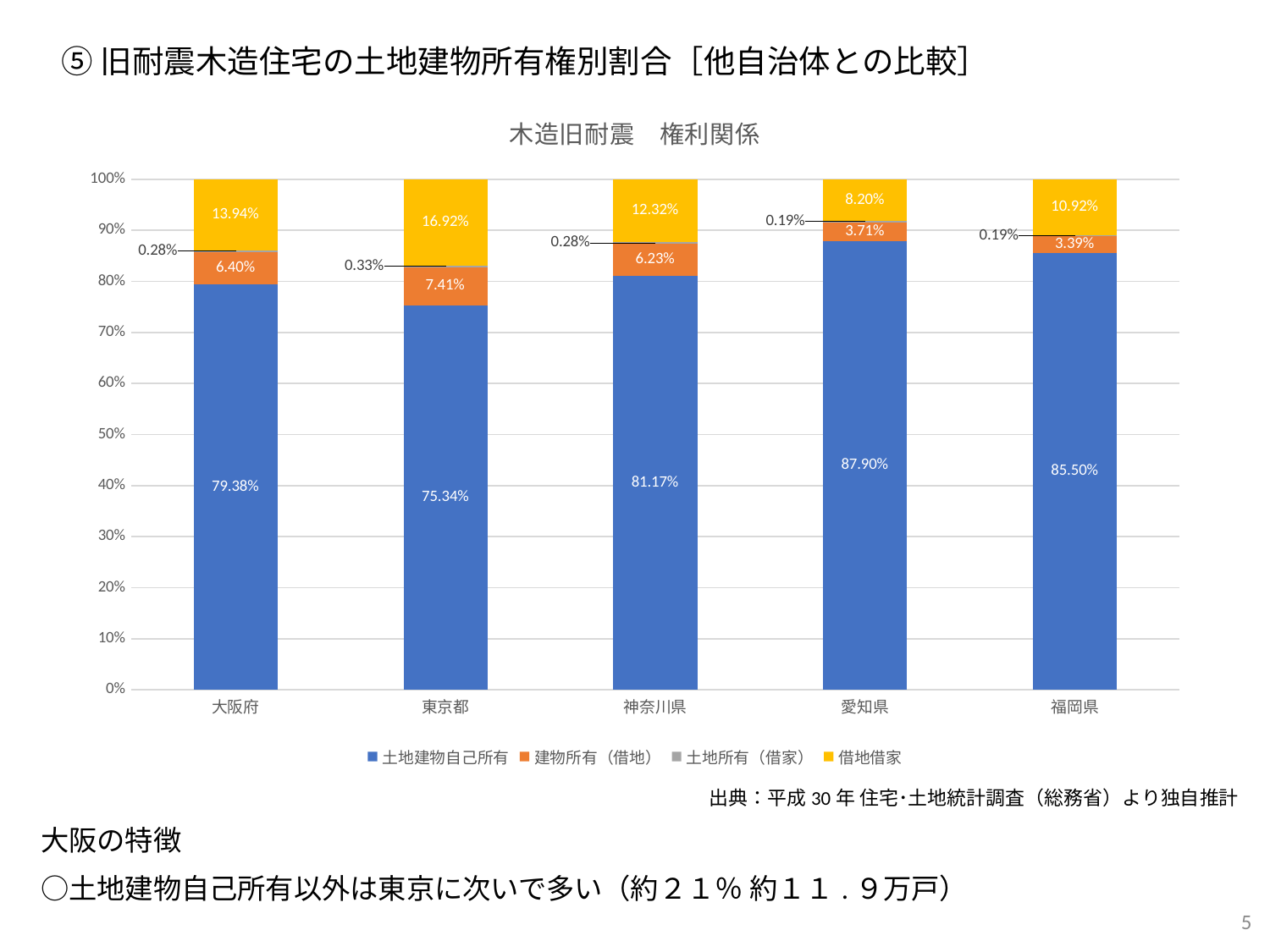
What is the title of the chart? 木造旧耐震 権利関係 What is the value of 土地所有（借家） for 愛知県? 0.19% What is the value of 建物所有（借地） for 神奈川県? 6.23% Which prefecture has the highest value for 土地建物自己所有? 愛知県 What is the difference between the 土地建物自己所有 values for 愛知県 and 東京都? 12.56% What is the value of 土地建物自己所有 for 大阪府? 79.38% Which prefecture has the lowest value for 借地借家? 愛知県 Which is larger, the 借地借家 value for 大阪府 or for 福岡県? 大阪府 What is the value of 借地借家 for 東京都? 16.92% What type of chart is shown on the slide? Stacked bar chart How many prefectures are shown on the x axis? 5 How many series does the legend list? 4